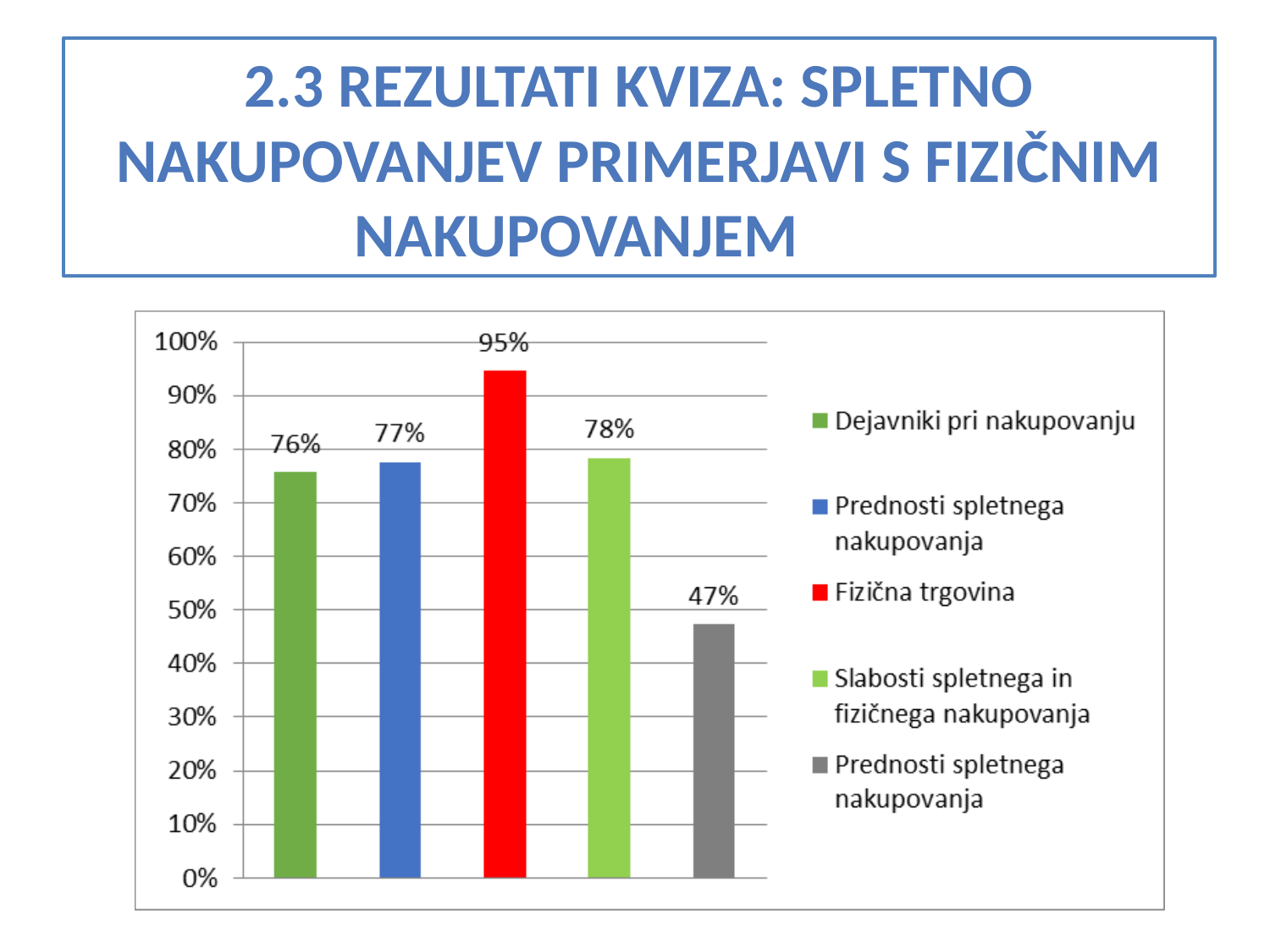
Which is larger: the value for Fizična trgovina or the value for Slabosti spletnega in fizičnega nakupovanja? Fizična trgovina Which bar has the lowest value? The grey bar (Prednosti spletnega nakupovanja, 47%) Is the value for Fizična trgovina greater or less than 90%? greater What kind of chart is shown on the slide? Bar chart How many bars are plotted in the chart? 5 What is the value shown by the grey bar (the second 'Prednosti spletnega nakupovanja' legend entry)? 47% What is the value for Slabosti spletnega in fizičnega nakupovanja? 78% What is the value for Fizična trgovina? 95% Which series has the highest value? Fizična trgovina What is the value shown by the blue bar (the first 'Prednosti spletnega nakupovanja' legend entry)? 77% What is the difference between the value for Fizična trgovina and the value for Dejavniki pri nakupovanju? 19% What is the value for Dejavniki pri nakupovanju? 76%